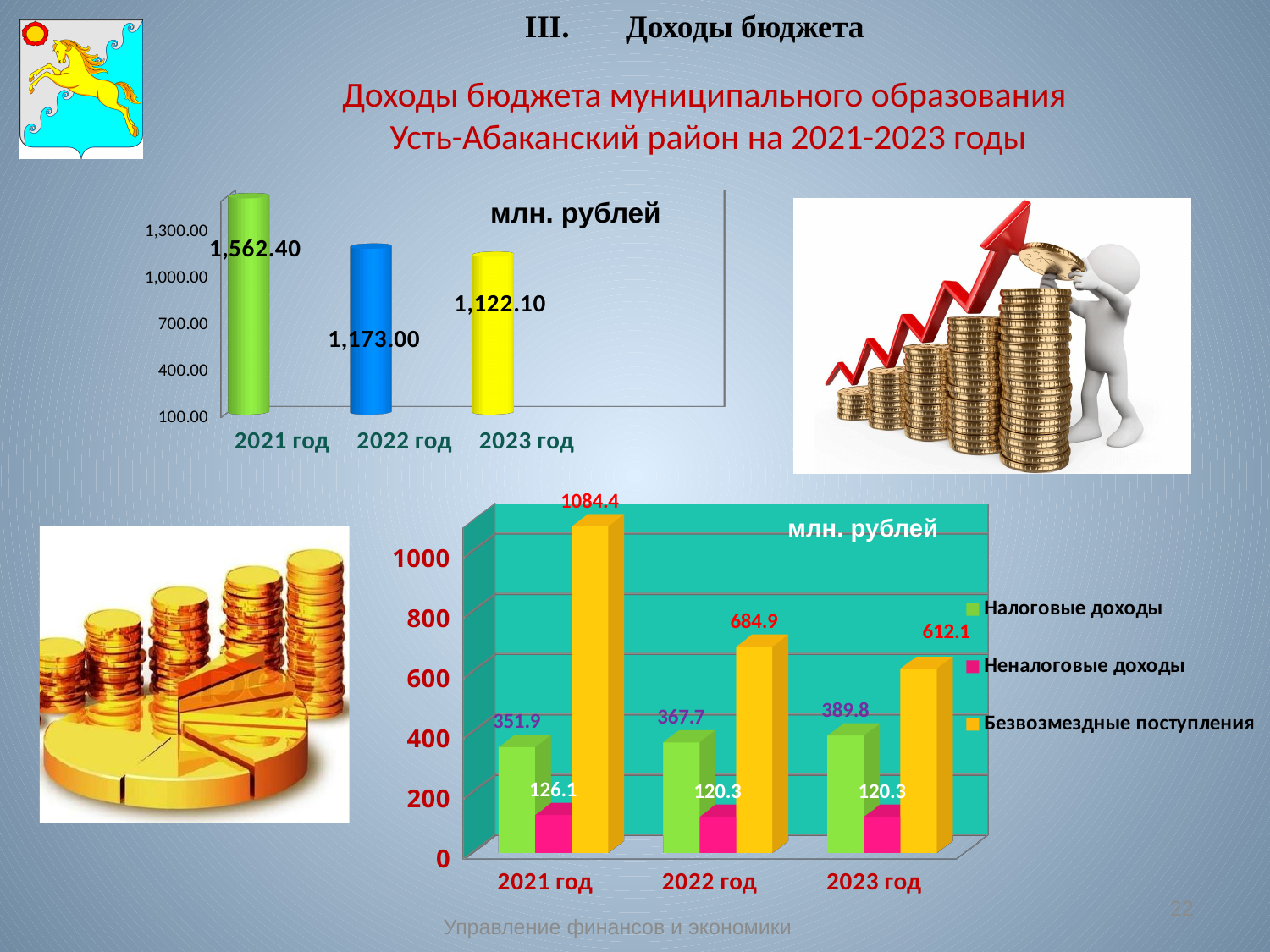
What kind of chart is the bottom chart? bar chart In the top-left chart, what is the value for 2023 год? 1,122.10 In the bottom chart, what is the value of Неналоговые доходы for 2022 год? 120.3 In the bottom chart, what is the value of Налоговые доходы for 2023 год? 389.8 In the bottom chart, which year has the lowest value for Безвозмездные поступления? 2023 год In the top-left chart, which year has the highest value? 2021 год In the top-left chart, what is the difference between the values for 2021 год and 2022 год? 389.40 In the bottom chart, what is the value of Безвозмездные поступления for 2021 год? 1084.4 In the bottom chart, how many series does the legend list? 3 In the top-left chart, do the values rise or fall from 2021 год to 2023 год? fall In the top-left chart, what is the value for 2021 год? 1,562.40 In the bottom chart, which is larger for 2022 год: Налоговые доходы or Неналоговые доходы? Налоговые доходы